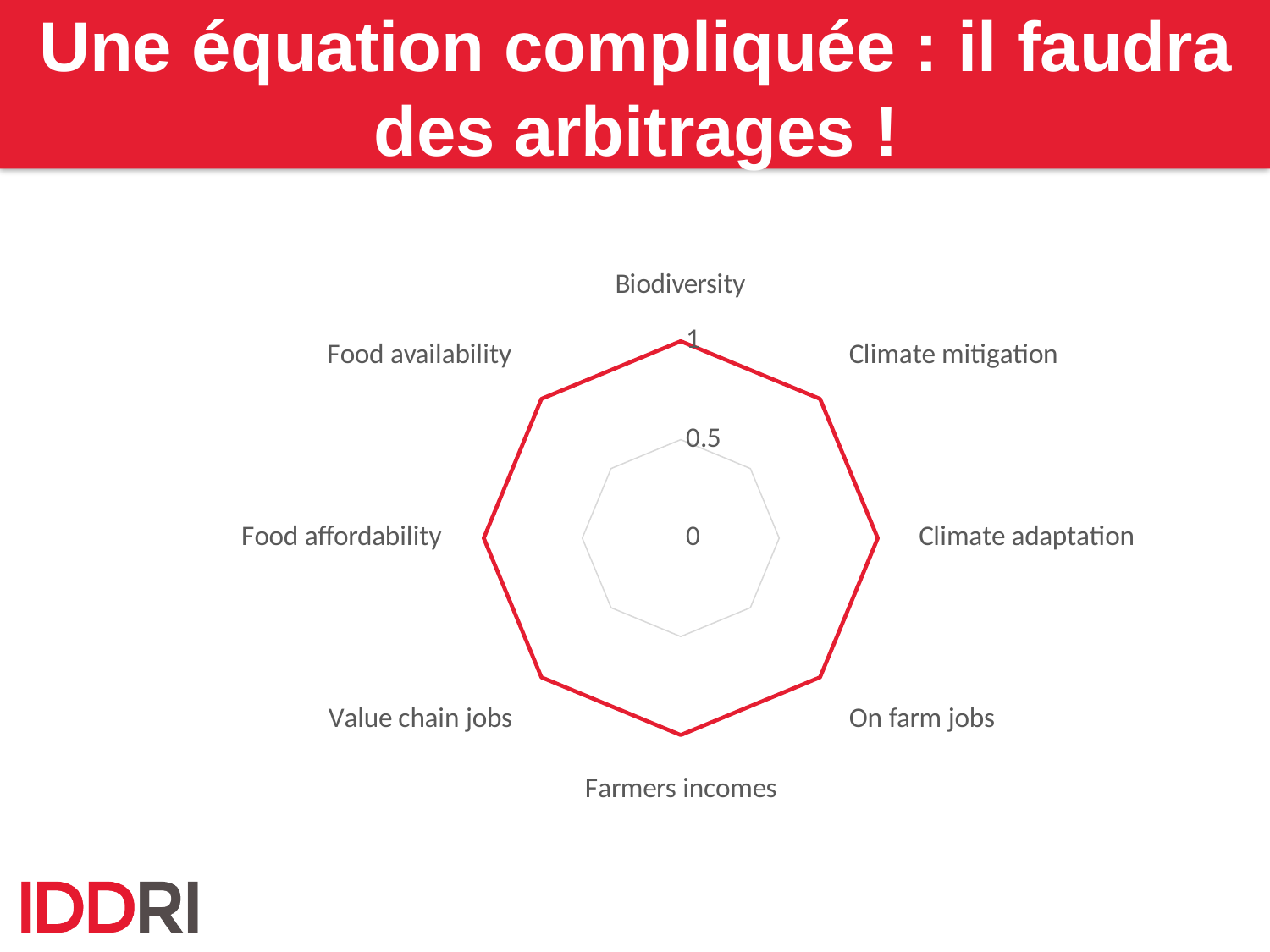
How many categories (axes) does the radar chart have? 8 Is the value for Value chain jobs greater or less than 0.5? greater Which category is labelled at the top of the radar chart? Biodiversity What is the value for Climate adaptation on the radar chart? 1 What is the value for Biodiversity on the radar chart? 1 What is the highest tick value shown on the radar chart's axis? 1 What is the difference between the values for Climate mitigation and Food availability? 0 What kind of chart is shown on the slide? radar chart What is the value for Food affordability on the radar chart? 1 Is the value for On farm jobs greater or less than 0.5? greater What is the value for Farmers incomes on the radar chart? 1